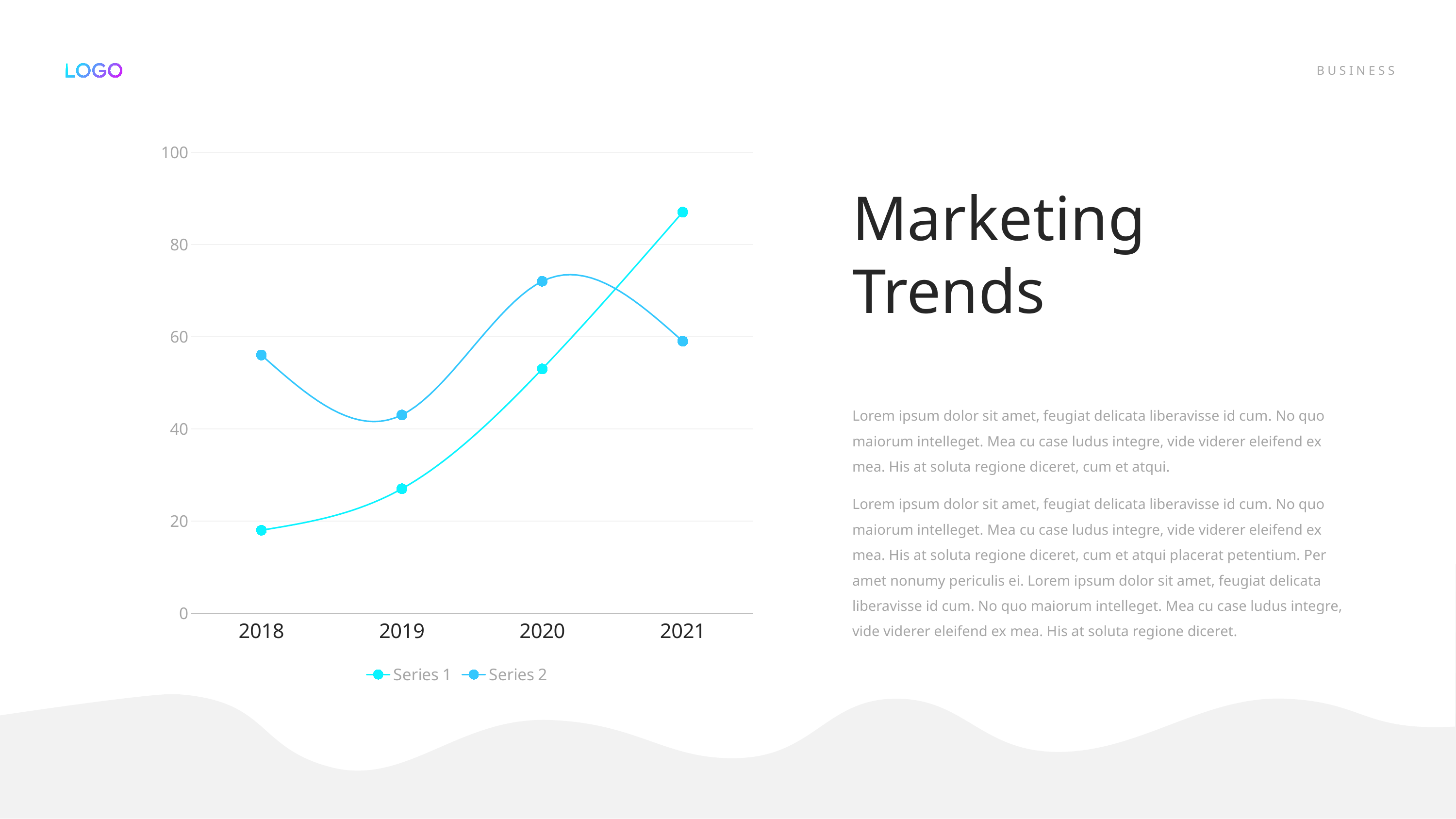
What are the names of the two series in the legend? Series 1 and Series 2 Do the values for Series 1 rise or fall from 2018 to 2021? rise What kind of chart is shown on the slide? line chart Is the value for Series 2 in 2020 greater or less than 60? greater In which year does Series 1 reach its highest value? 2021 Is the value for Series 2 in 2019 greater or less than 60? less In which year does Series 2 have its lowest value? 2019 How many series does the legend list? 2 Is the value for Series 1 in 2018 greater or less than 20? less In 2020, which series has the larger value, Series 1 or Series 2? Series 2 How many years are shown on the x axis? 4